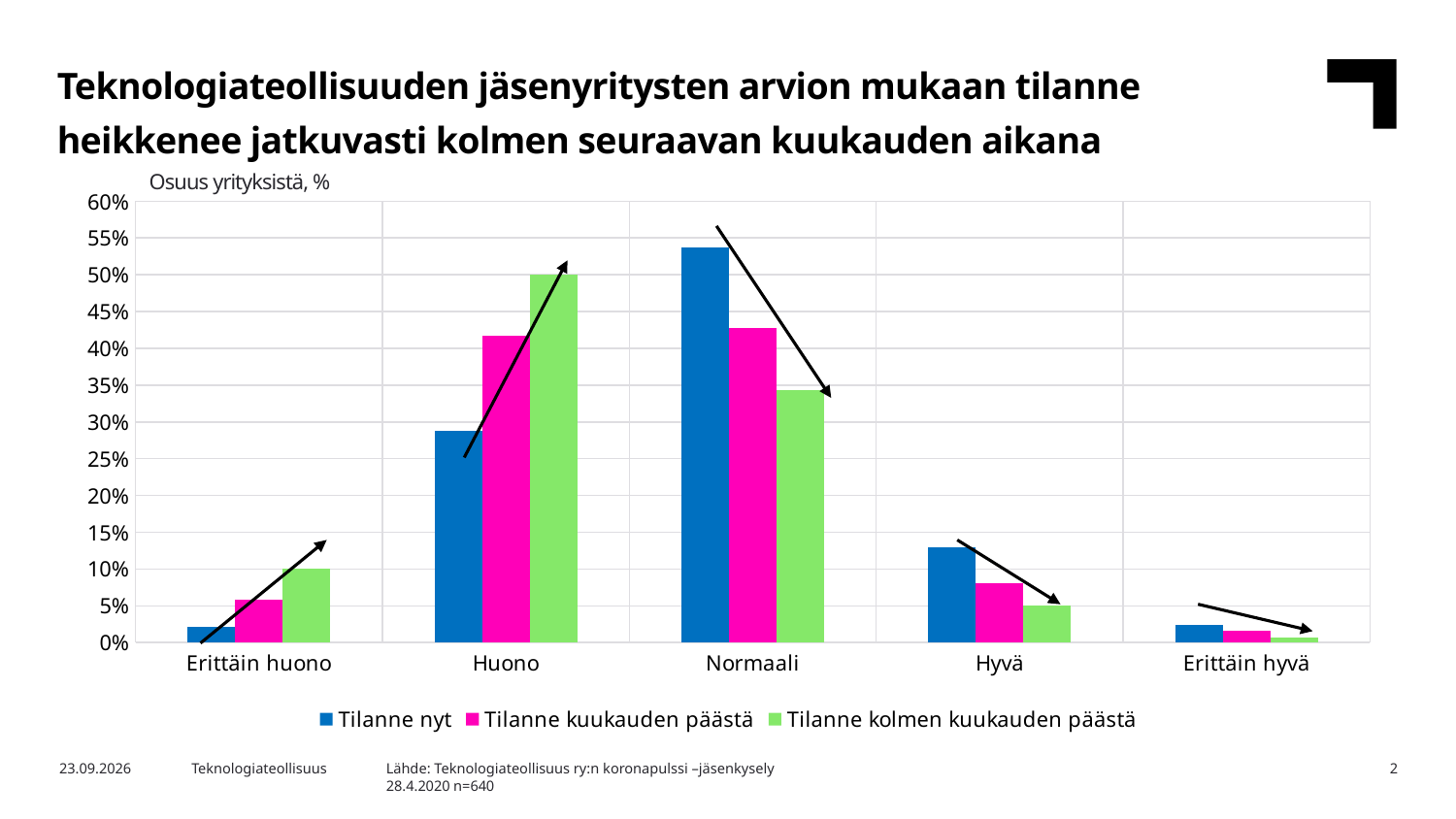
Which category has the highest value for Tilanne nyt? Normaali What is the label shown above the vertical axis of the chart? Osuus yrityksistä, % Is the value for Tilanne nyt in the Huono category greater or less than 35%? less How many series does the legend list? 3 Is the value for Tilanne nyt in the Normaali category greater or less than 50%? greater Which category has the highest value for Tilanne kolmen kuukauden päästä? Huono In the Hyvä category, which is larger: Tilanne nyt or Tilanne kolmen kuukauden päästä? Tilanne nyt How many categories are shown on the x axis? 5 In the Huono category, which is larger: Tilanne nyt or Tilanne kuukauden päästä? Tilanne kuukauden päästä What kind of chart is shown on the slide? Bar chart Is the value for Tilanne kolmen kuukauden päästä in the Normaali category greater or less than 40%? less Which category has the lowest value for Tilanne kolmen kuukauden päästä? Erittäin hyvä